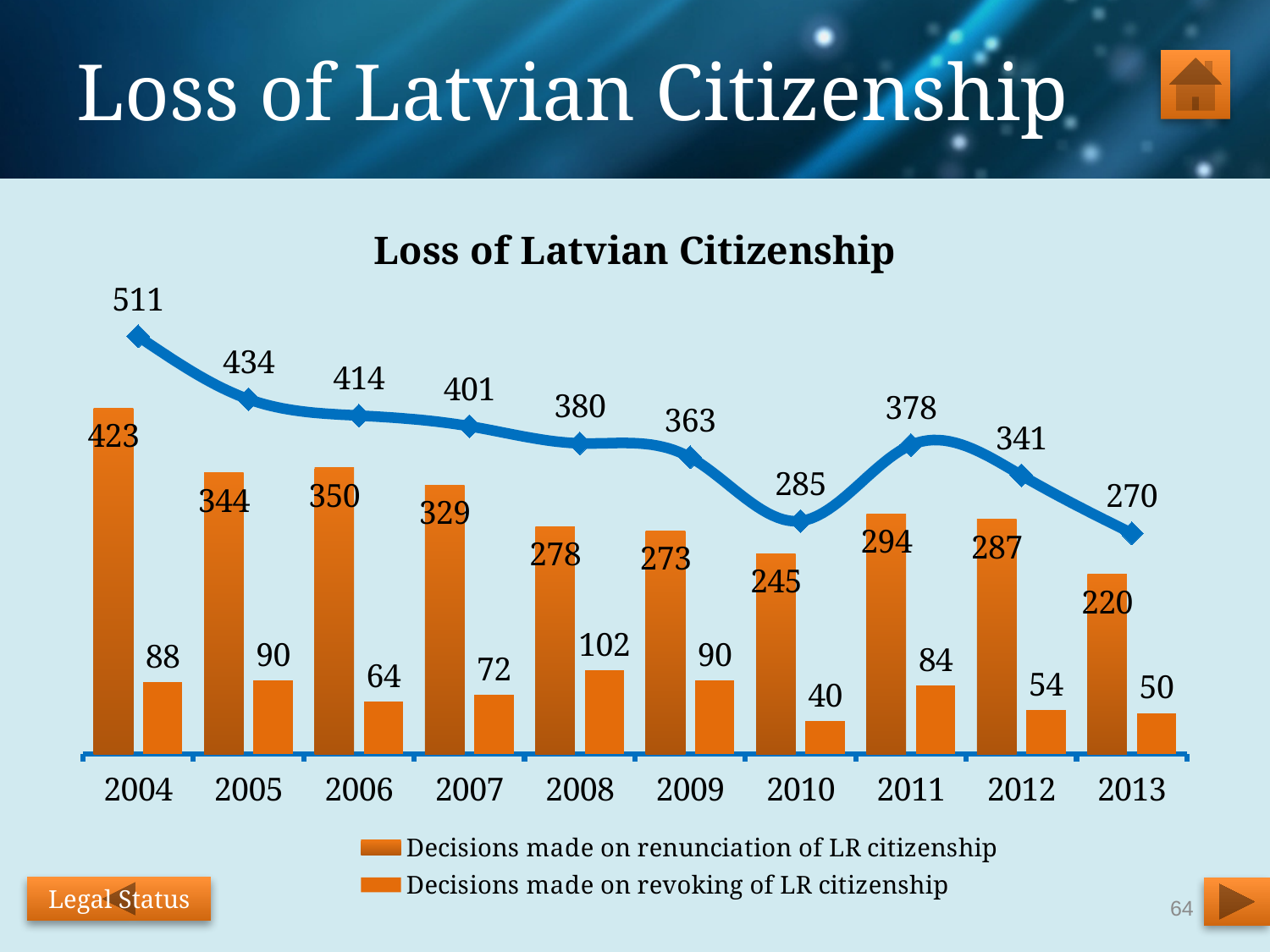
Which is larger: decisions made on renunciation of LR citizenship in 2011 or in 2012? 2011 Do the decisions made on renunciation of LR citizenship generally rise or fall from 2004 to 2013? fall In which year were decisions made on renunciation of LR citizenship the highest? 2004 How many series does the legend list? 2 How many years are shown on the x axis of the chart? 10 What is the difference between decisions made on renunciation of LR citizenship in 2004 and in 2013? 203 What value does the line show for 2004? 511 How many decisions were made on renunciation of LR citizenship in 2004? 423 What is the title of the chart? Loss of Latvian Citizenship In which year were decisions made on revoking of LR citizenship the lowest? 2010 What kind of chart is used for the decisions on renunciation and revoking of LR citizenship? bar chart How many decisions were made on revoking of LR citizenship in 2008? 102